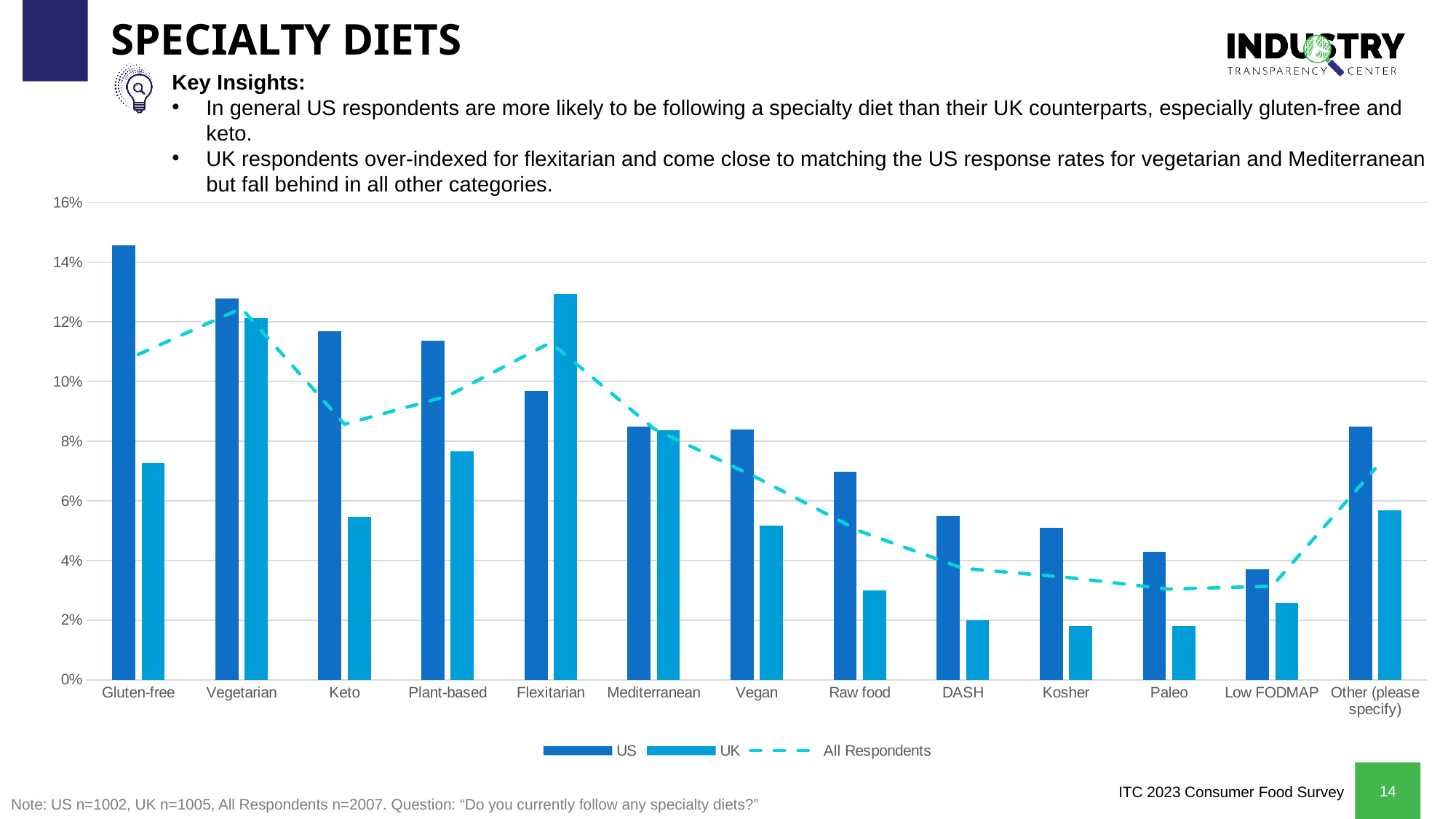
How many diet categories are shown on the x axis of the chart? 13 Is the UK value for Raw food greater or less than 4%? less For Gluten-free, which is larger, the US value or the UK value? US Which diet category has the highest UK value? Flexitarian For Flexitarian, which is larger, the US value or the UK value? UK Which diet category has the highest US value? Gluten-free Which diet category has the lowest US value? Low FODMAP Does the All Respondents line rise or fall from Flexitarian to Paleo? fall Is the US value for Gluten-free greater or less than 14%? greater What kind of chart is shown on the slide? Bar chart (with a dashed line for All Respondents) How many series does the chart legend list? 3 Is the UK value for Keto greater or less than 6%? less